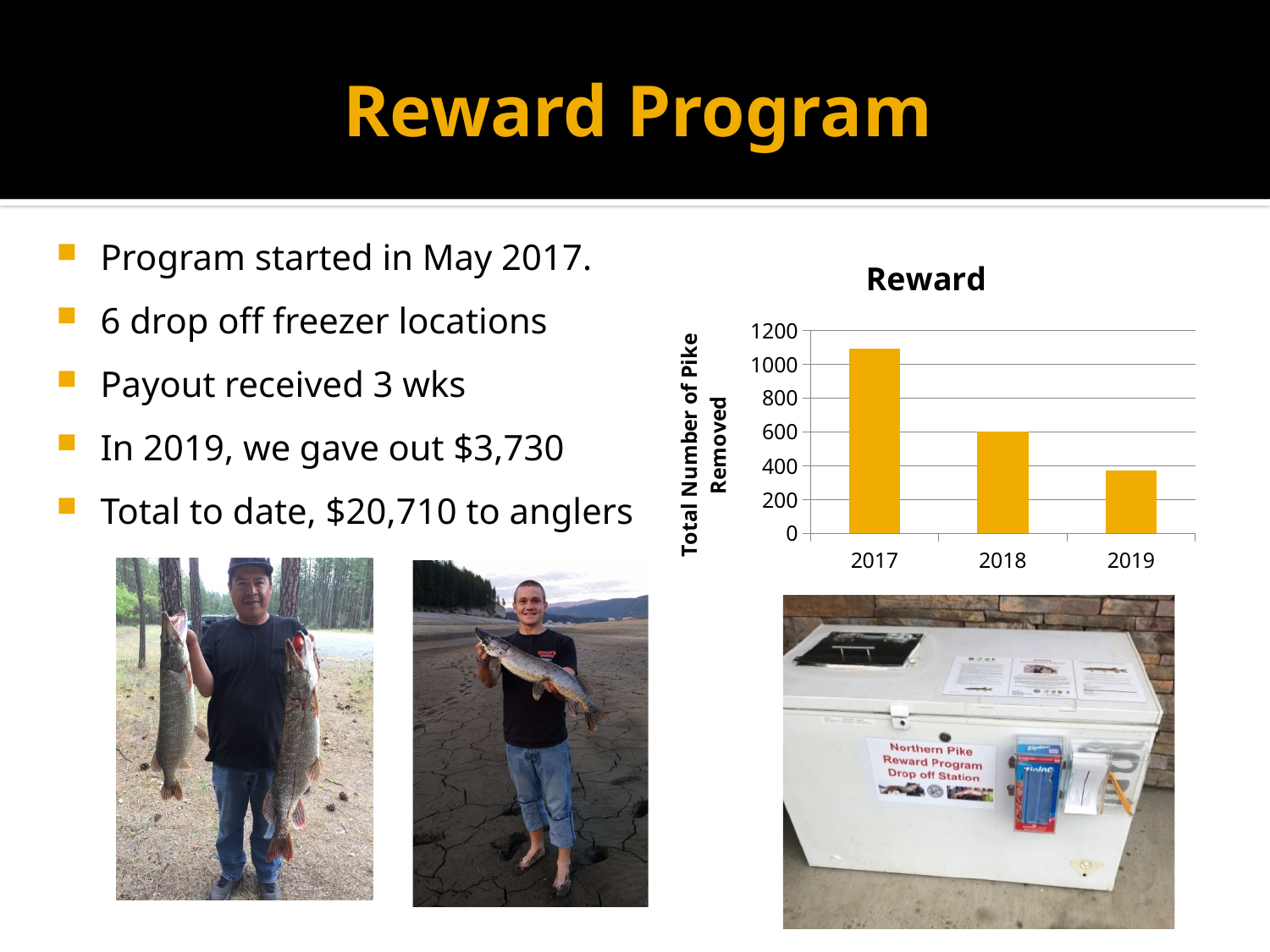
What kind of chart is shown on the slide? bar chart Does the total number of pike removed rise or fall from 2017 to 2019? fall Which year had more pike removed, 2017 or 2018? 2017 Which year had more pike removed, 2018 or 2019? 2018 What is the title of the chart? Reward Is the value for 2017 greater or less than 1000? greater Which year has the lowest total number of pike removed? 2019 How many years are shown on the x axis of the chart? 3 Which year has the highest total number of pike removed? 2017 Is the value for 2019 greater or less than 600? less Is the value for 2018 greater or less than 800? less What is the label on the vertical axis of the chart? Total Number of Pike Removed